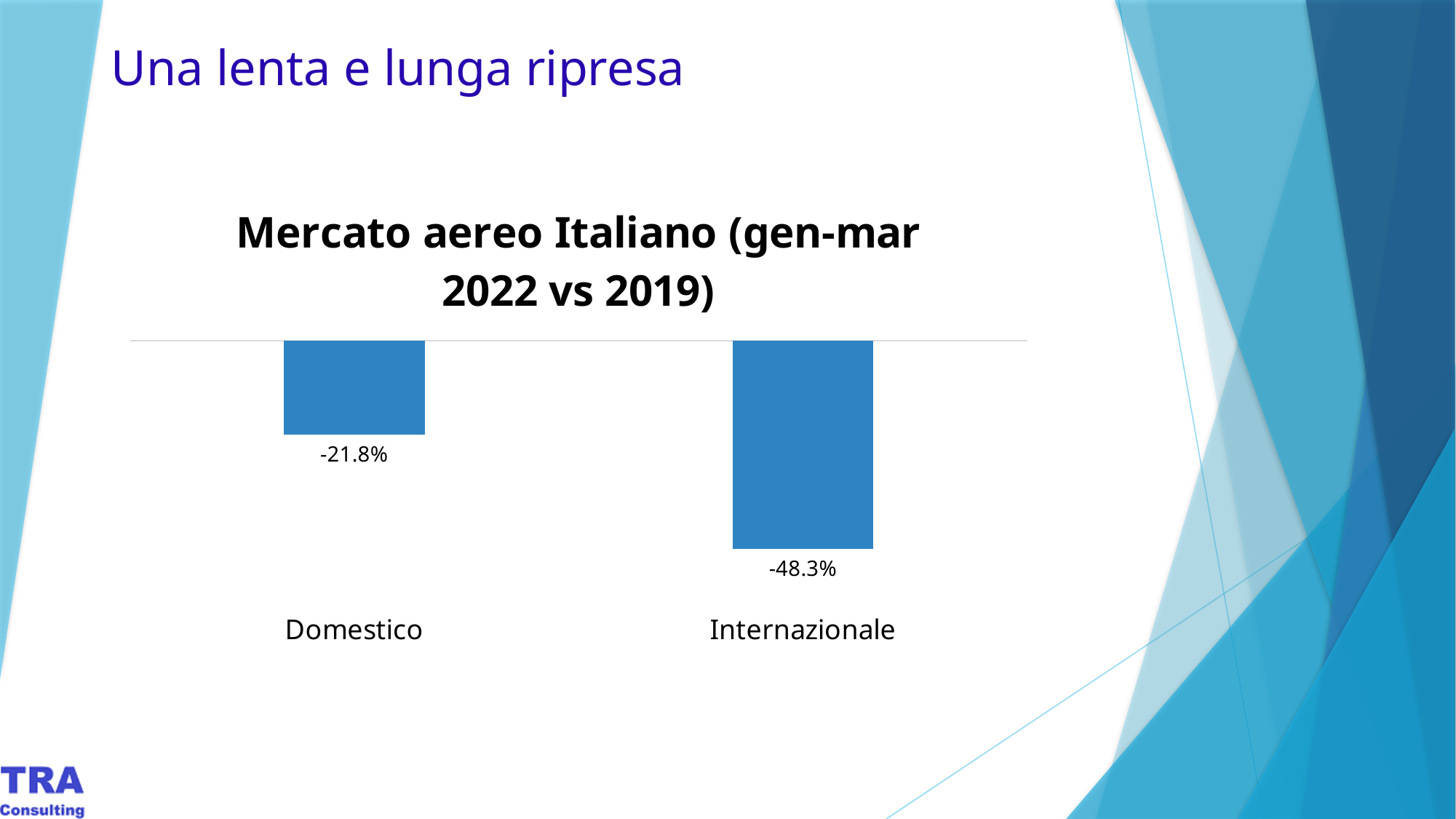
What is the value for Internazionale? -48.3% Which category has the highest value? Domestico What is the value for Domestico? -21.8% How many categories are shown in the chart? 2 Do the values rise or fall from Domestico to Internazionale? Fall Are the values in the chart positive or negative? Negative What is the title of the chart? Mercato aereo Italiano (gen-mar 2022 vs 2019) What kind of chart is shown on the slide? Bar chart What is the difference between the values for Domestico and Internazionale? 26.5 percentage points Which category has the lowest value? Internazionale Which is larger, the value for Domestico or the value for Internazionale? Domestico